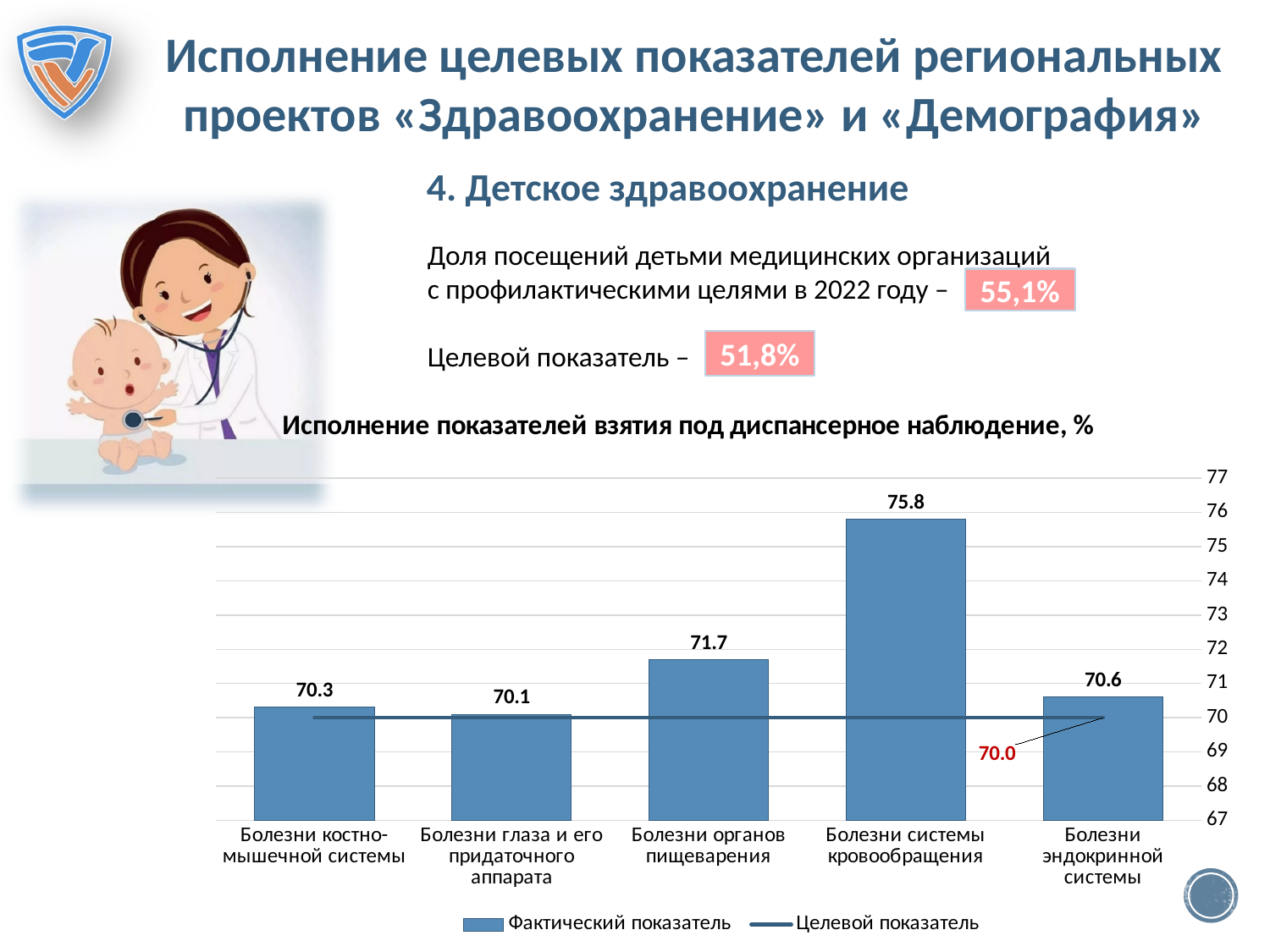
How many categories are shown on the x axis of the chart? 5 What is the value of the actual indicator (Фактический показатель) for Болезни системы кровообращения? 75.8 What is the value of the actual indicator for Болезни органов пищеварения? 71.7 What is the difference between the actual indicator for Болезни системы кровообращения and Болезни органов пищеварения? 4.1 What is the target indicator (Целевой показатель) value shown on the chart? 70.0 What is the value of the actual indicator for Болезни эндокринной системы? 70.6 What is the title of the chart? Исполнение показателей взятия под диспансерное наблюдение, % How many series does the chart legend list? 2 Which is larger: the actual indicator for Болезни костно-мышечной системы or for Болезни эндокринной системы? Болезни эндокринной системы Which category has the highest actual indicator value? Болезни системы кровообращения Which category has the lowest actual indicator value? Болезни глаза и его придаточного аппарата What kind of chart is used to show the actual indicator values? Bar chart